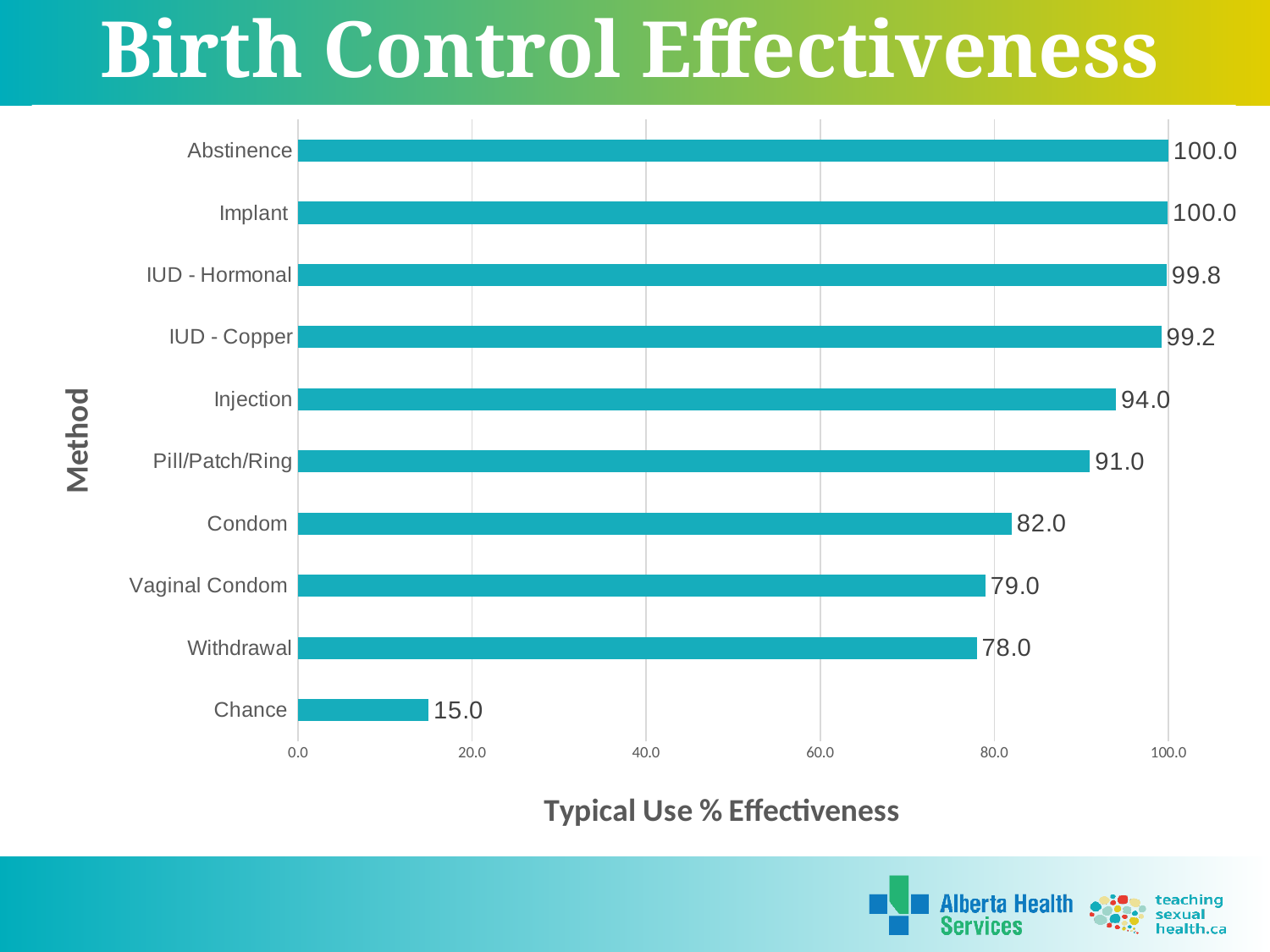
Is the value for Withdrawal greater or less than 80.0? less What is the typical use % effectiveness for IUD - Copper? 99.2 What is the difference in typical use % effectiveness between Pill/Patch/Ring and Withdrawal? 13.0 Which has a higher typical use % effectiveness, Injection or Pill/Patch/Ring? Injection What is the typical use % effectiveness for Condom? 82.0 What kind of chart is shown on the slide? bar chart What is the label of the horizontal axis? Typical Use % Effectiveness What is the label of the vertical axis? Method How many methods are shown in the chart? 10 What is the typical use % effectiveness for Injection? 94.0 What is the difference in typical use % effectiveness between Condom and Vaginal Condom? 3.0 Which method has the lowest typical use % effectiveness? Chance